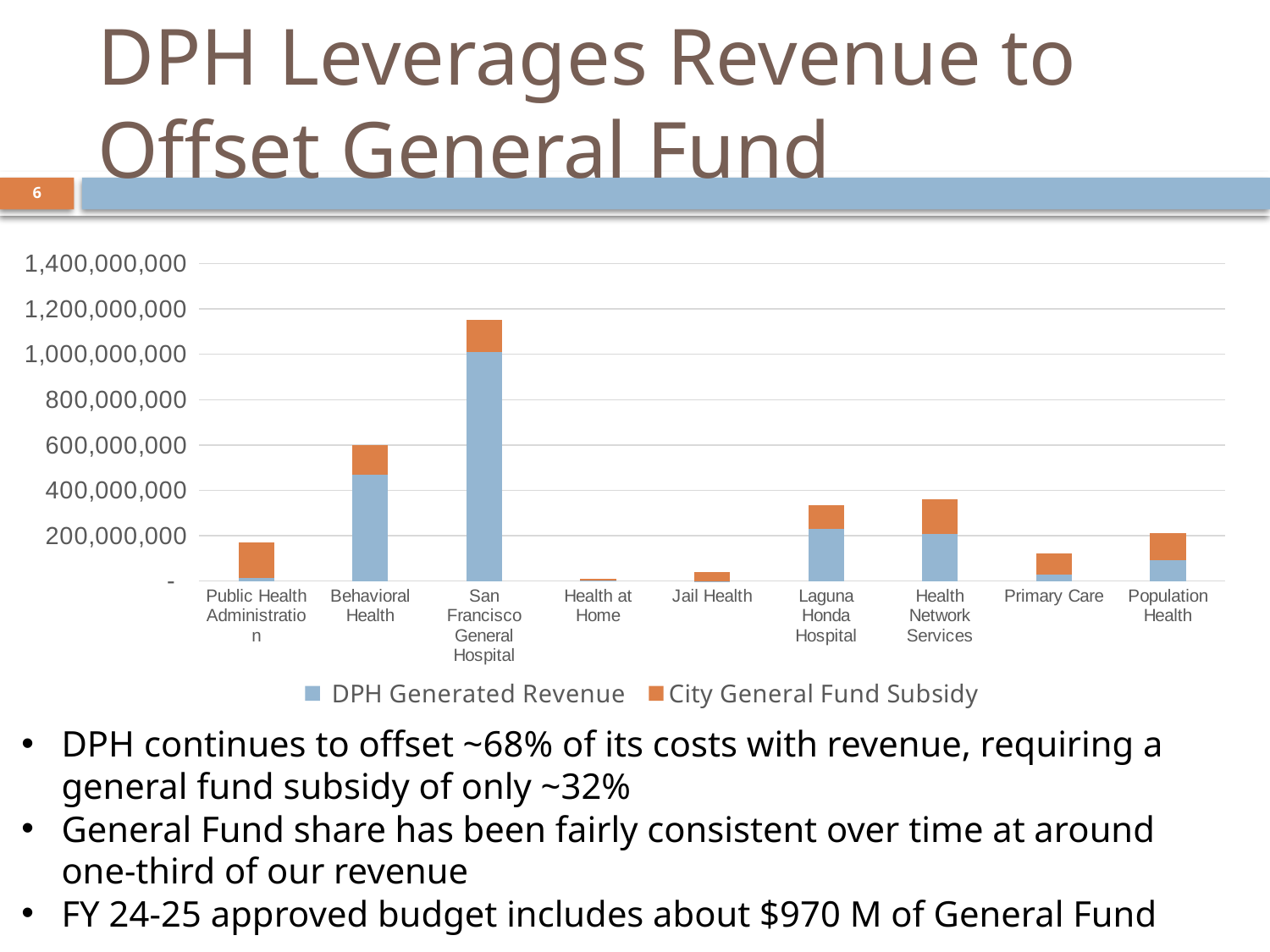
How many categories (divisions) are shown on the x axis of the chart? 9 Which has the larger total bar, Behavioral Health or Laguna Honda Hospital? Behavioral Health How many series does the chart's legend list? 2 Is the total bar for Behavioral Health greater or less than 400,000,000? greater Is the total bar for Public Health Administration greater or less than 200,000,000? less Which category has the tallest stacked bar in the chart? San Francisco General Hospital Which category has the shortest stacked bar in the chart? Health at Home Is the total bar for San Francisco General Hospital greater or less than 1,000,000,000? greater What kind of chart is shown on the slide? Stacked bar chart Which has the larger total bar, Health Network Services or Primary Care? Health Network Services What are the two series named in the chart's legend? DPH Generated Revenue and City General Fund Subsidy